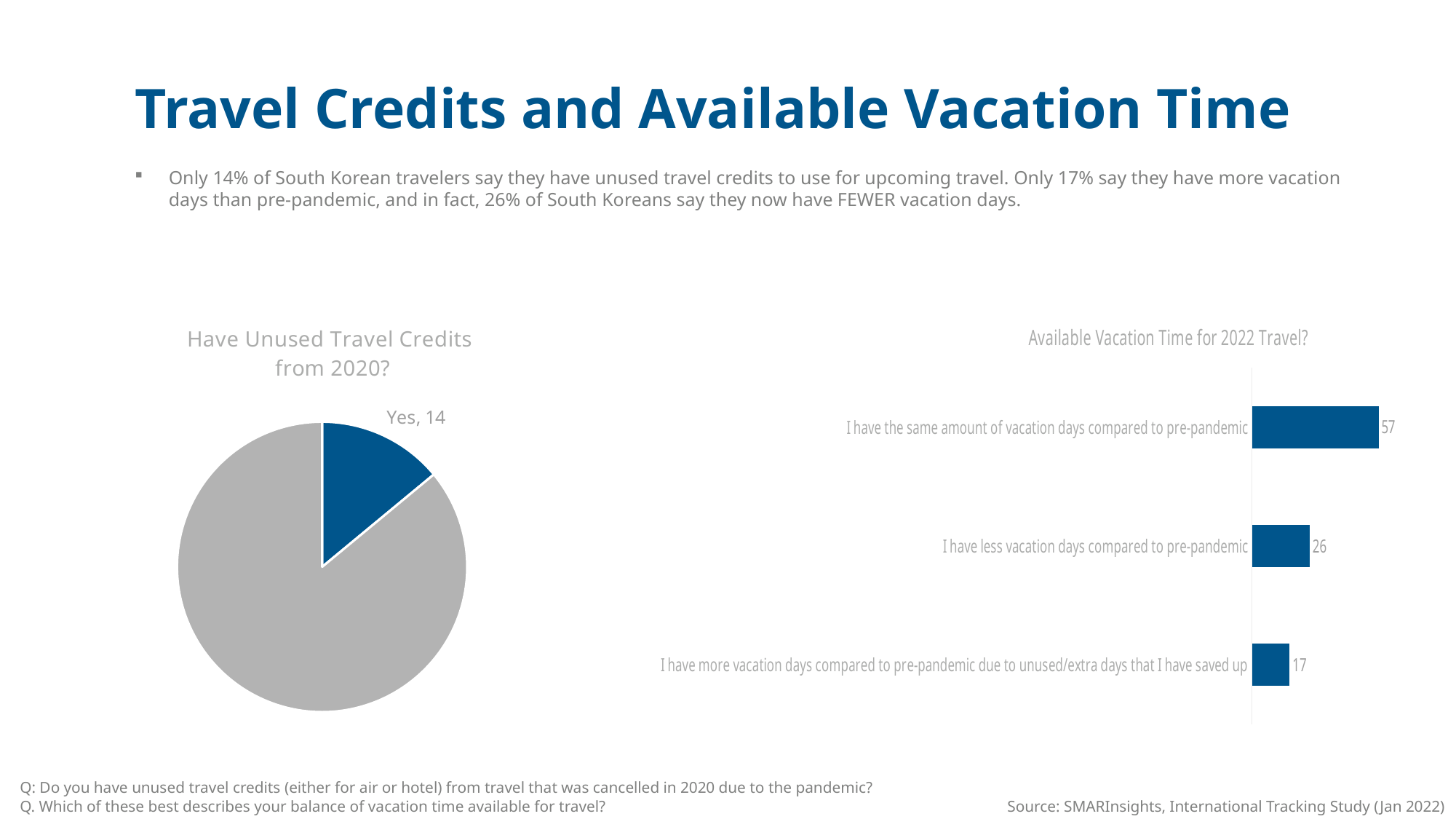
In the 'Available Vacation Time for 2022 Travel?' chart, which category has the highest value? I have the same amount of vacation days compared to pre-pandemic In the 'Available Vacation Time for 2022 Travel?' chart, which category has the lowest value? I have more vacation days compared to pre-pandemic due to unused/extra days that I have saved up In the 'Have Unused Travel Credits from 2020?' pie chart, what colour is the 'Yes' slice? blue What kind of chart is 'Available Vacation Time for 2022 Travel?'? bar chart What kind of chart is 'Have Unused Travel Credits from 2020?'? pie chart In the 'Have Unused Travel Credits from 2020?' chart, what value is shown for the 'Yes' slice? 14 In the 'Available Vacation Time for 2022 Travel?' chart, what is the value for 'I have more vacation days compared to pre-pandemic due to unused/extra days that I have saved up'? 17 In the 'Available Vacation Time for 2022 Travel?' chart, what is the value for 'I have the same amount of vacation days compared to pre-pandemic'? 57 How many bars are shown in the 'Available Vacation Time for 2022 Travel?' chart? 3 In the 'Available Vacation Time for 2022 Travel?' chart, what is the value for 'I have less vacation days compared to pre-pandemic'? 26 In the 'Available Vacation Time for 2022 Travel?' chart, which is larger: the value for 'I have less vacation days compared to pre-pandemic' or the value for 'I have more vacation days compared to pre-pandemic due to unused/extra days that I have saved up'? I have less vacation days compared to pre-pandemic In the 'Available Vacation Time for 2022 Travel?' chart, what is the difference between the value for 'I have the same amount of vacation days compared to pre-pandemic' and the value for 'I have less vacation days compared to pre-pandemic'? 31